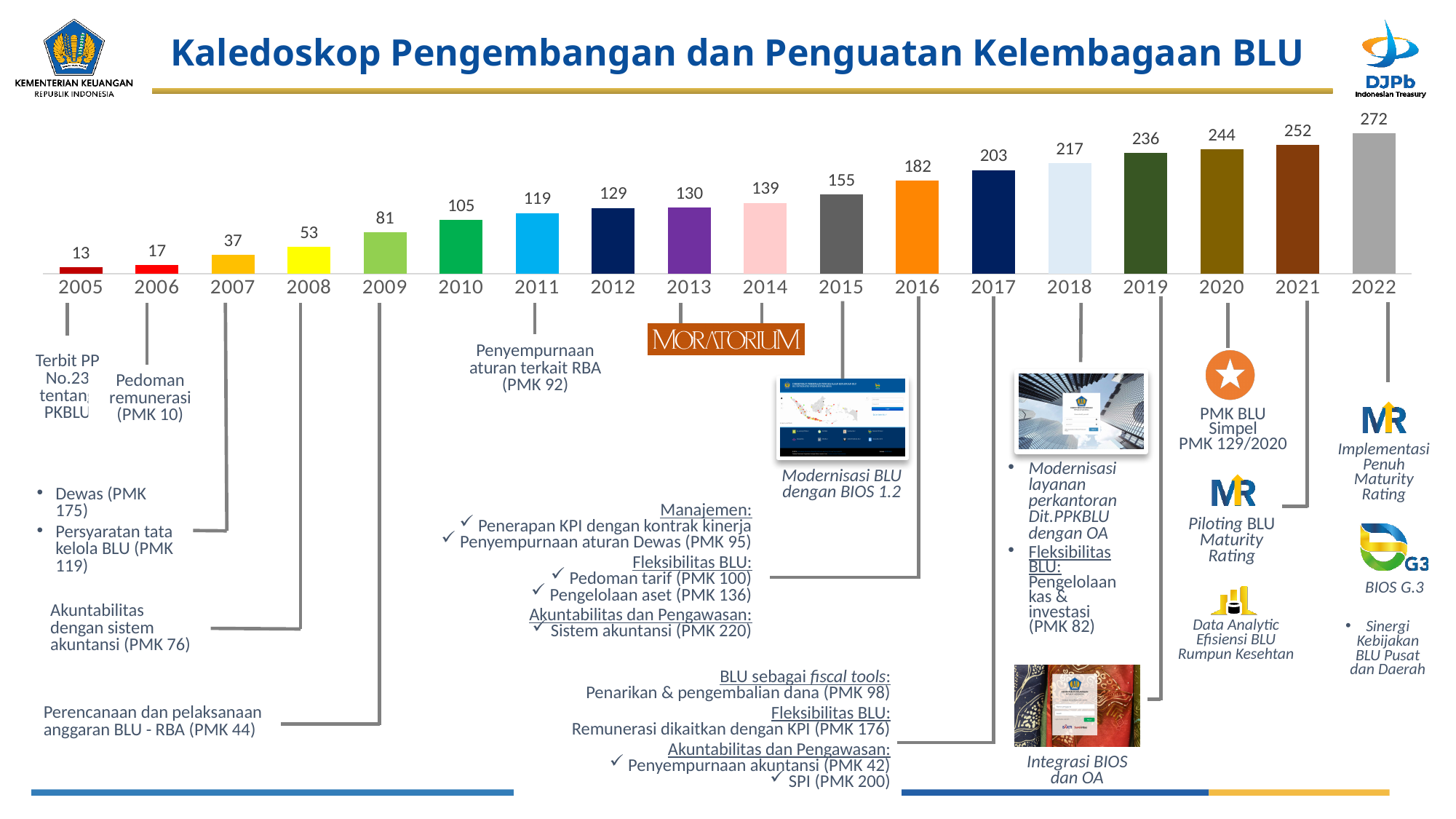
Which year has the highest value in the chart? 2022 Do the values rise or fall from 2005 to 2022? rise Which year has the lowest value in the chart? 2005 What is the difference between the values for 2022 and 2021? 20 What is the title of the slide containing the chart? Kaledoskop Pengembangan dan Penguatan Kelembagaan BLU Which is larger, the value for 2013 or the value for 2014? 2014 What is the value shown for 2009? 81 What kind of chart is shown on the slide? bar chart What is the value shown for 2015? 155 What is the difference between the values for 2016 and 2015? 27 How many years (bars) are shown in the chart? 18 What is the value shown for 2021? 252